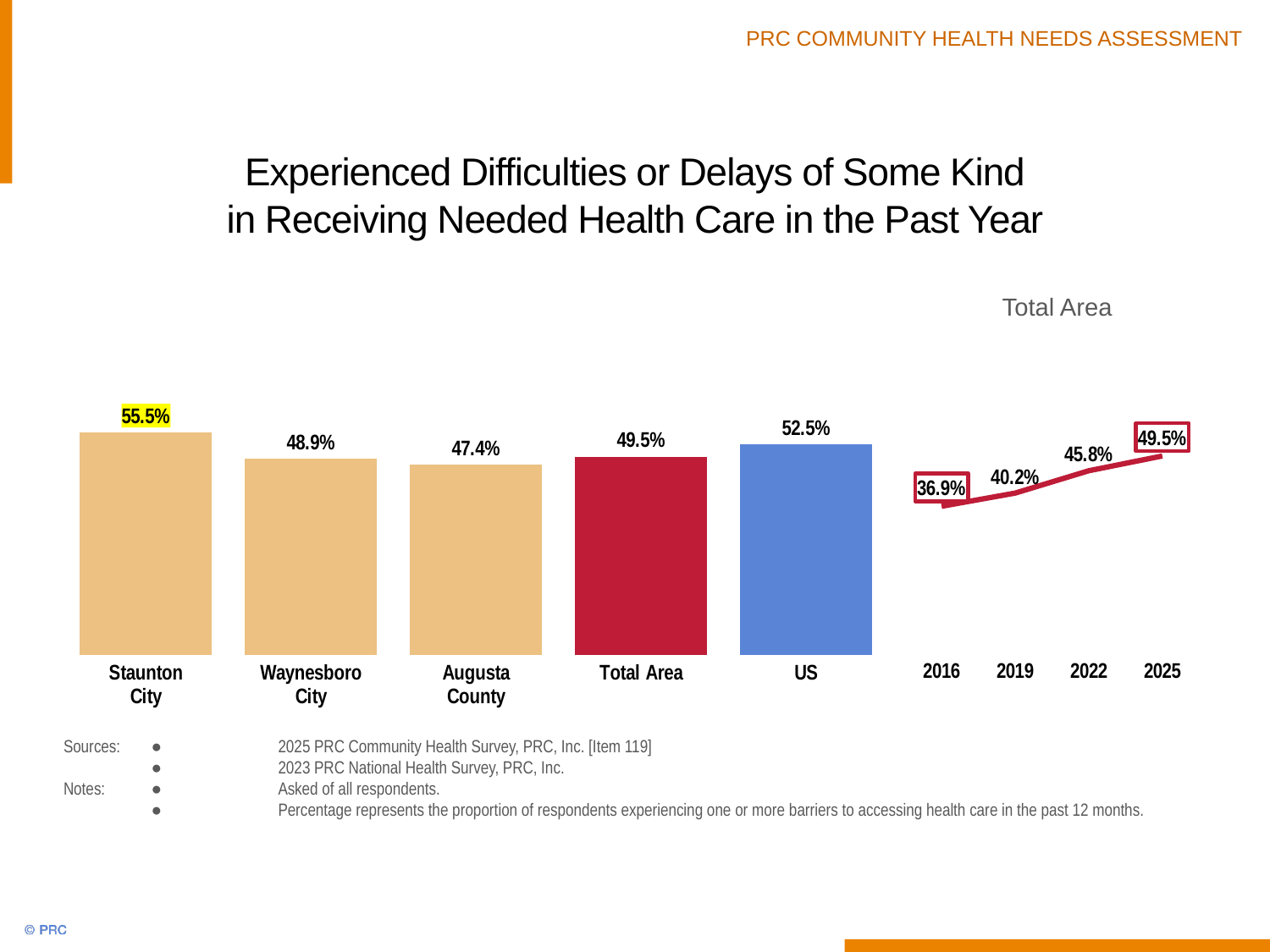
In the bar chart, which category has the lowest value? Augusta County In the Total Area trend chart on the right, what is the value for 2016? 36.9% How many categories does the bar chart show? 5 In the Total Area trend chart on the right, what is the value for 2019? 40.2% In the bar chart, what is the value for the US? 52.5% In the bar chart, which category has the highest value? Staunton City In the Total Area trend chart on the right, do the values rise or fall from 2016 to 2025? rise In the bar chart, which is larger, the value for Total Area or the value for the US? US In the bar chart, what is the value for Augusta County? 47.4% In the bar chart, what is the value for Staunton City? 55.5% In the Total Area trend chart on the right, what is the difference between the 2025 value and the 2016 value? 12.6% In the bar chart, what is the difference between the Staunton City value and the Waynesboro City value? 6.6%